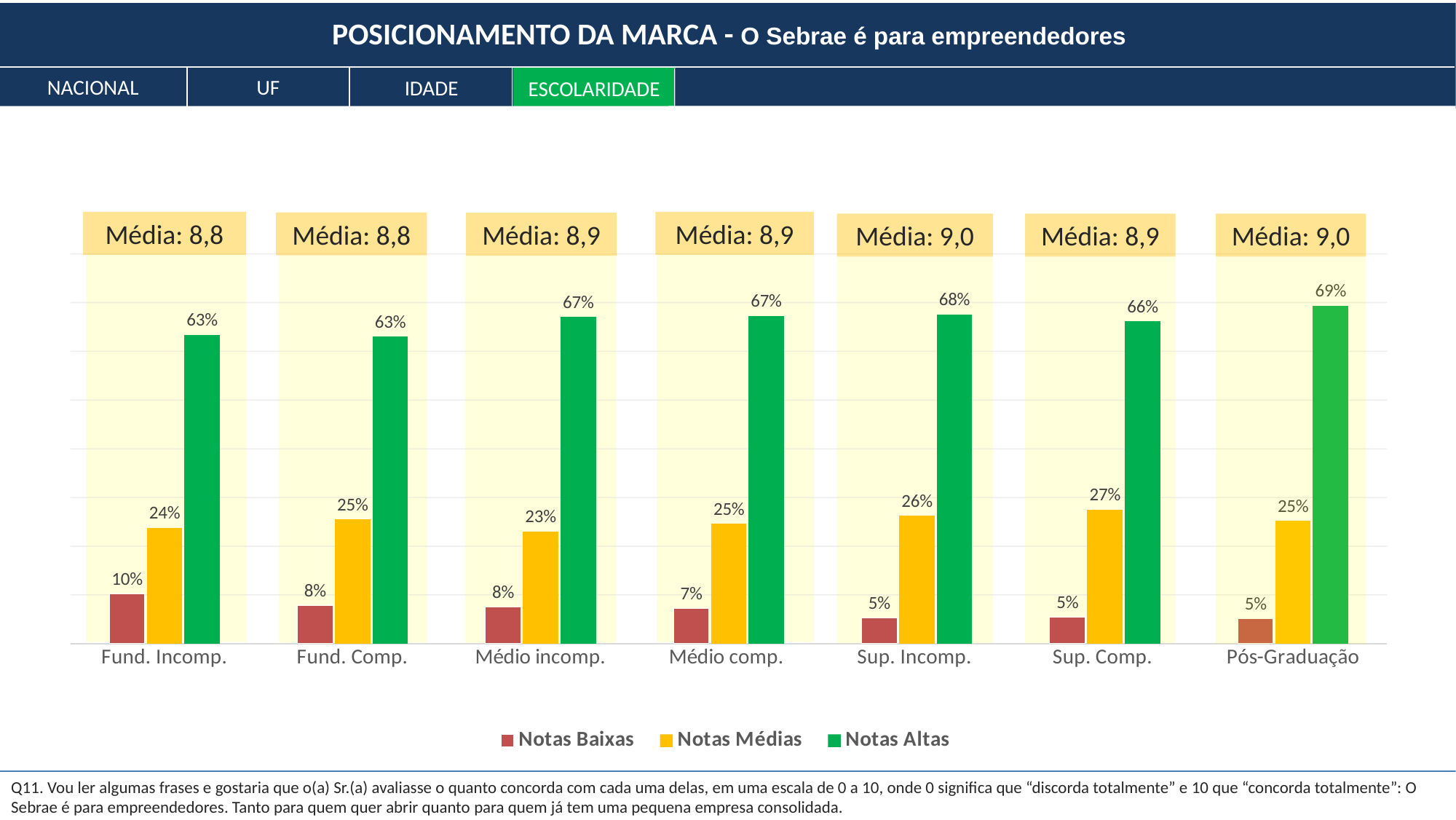
What is the Média shown above the Sup. Incomp. category? 9,0 Which category has the lowest Notas Médias value? Médio incomp. Which category has the highest Notas Altas value? Pós-Graduação Which is larger: Notas Médias for Sup. Comp. or Notas Médias for Médio incomp.? Sup. Comp. What is the value of Notas Baixas for Fund. Incomp.? 10% Which category has the highest Notas Baixas value? Fund. Incomp. What kind of chart is shown on the slide? Bar chart What is the value of Notas Altas for Pós-Graduação? 69% How many series does the legend list? 3 What is the value of Notas Médias for Sup. Comp.? 27% How many categories are shown on the x axis? 7 What is the difference between Notas Altas for Pós-Graduação and Notas Altas for Fund. Incomp.? 6%